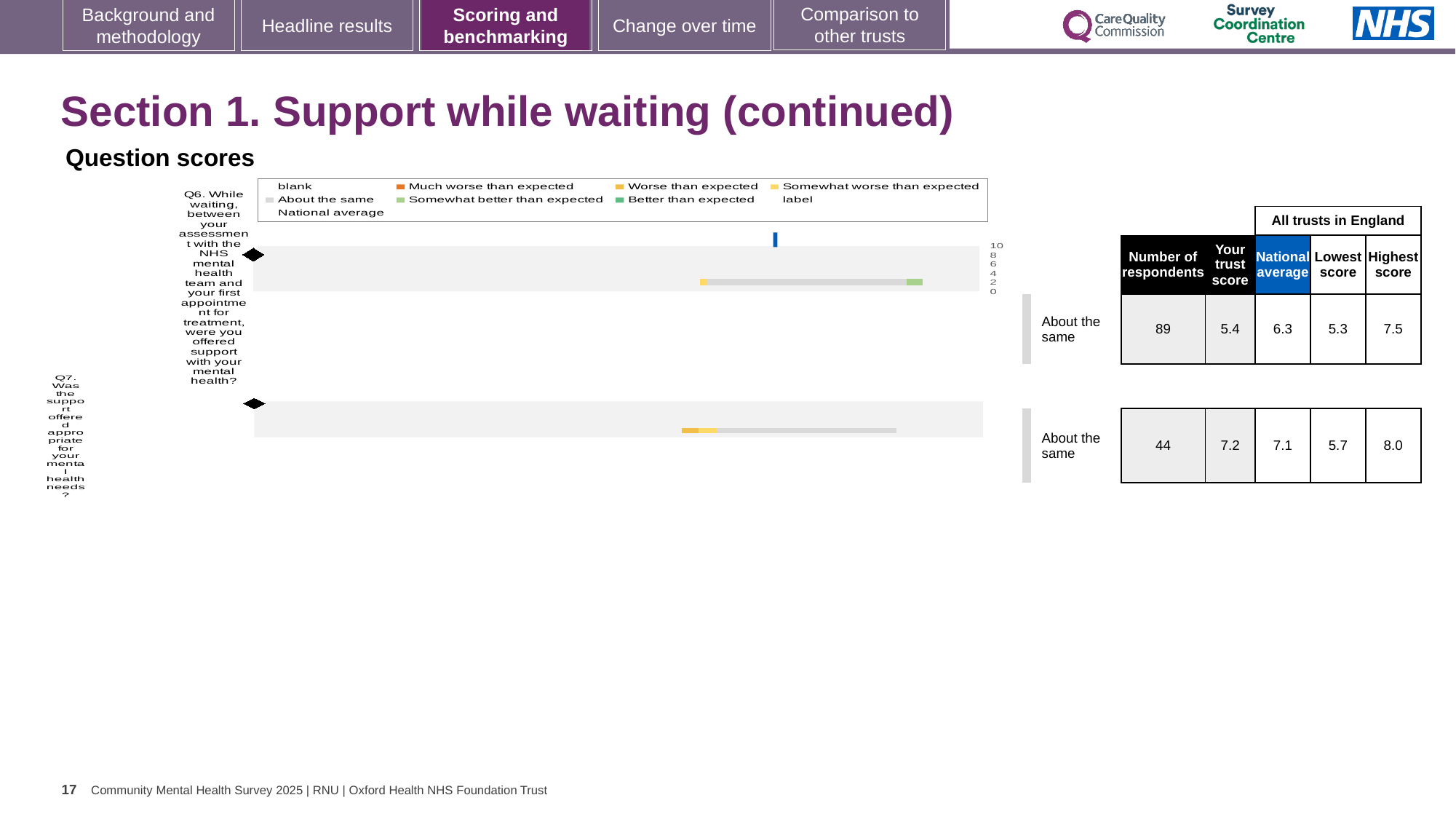
What colour does the legend use for 'Better than expected'? Green What is the highest score among all trusts in England for Q6? 7.5 How many respondents answered Q7? 44 For Q6, which is larger: the trust score or the national average? National average How many questions (rows) are plotted in the question scores chart? 2 By how much does the national average exceed the trust score for Q6? 0.9 What is the 'Your trust score' value for Q7 (was the support offered appropriate)? 7.2 What is the national average score for Q6? 6.3 What kind of chart is used to show the question scores on this slide? bar chart What is the difference between the highest score and the lowest score for Q7? 2.3 What is the 'Your trust score' value for Q6 (support with mental health while waiting)? 5.4 What benchmark category is shown for Q6 next to the chart? About the same